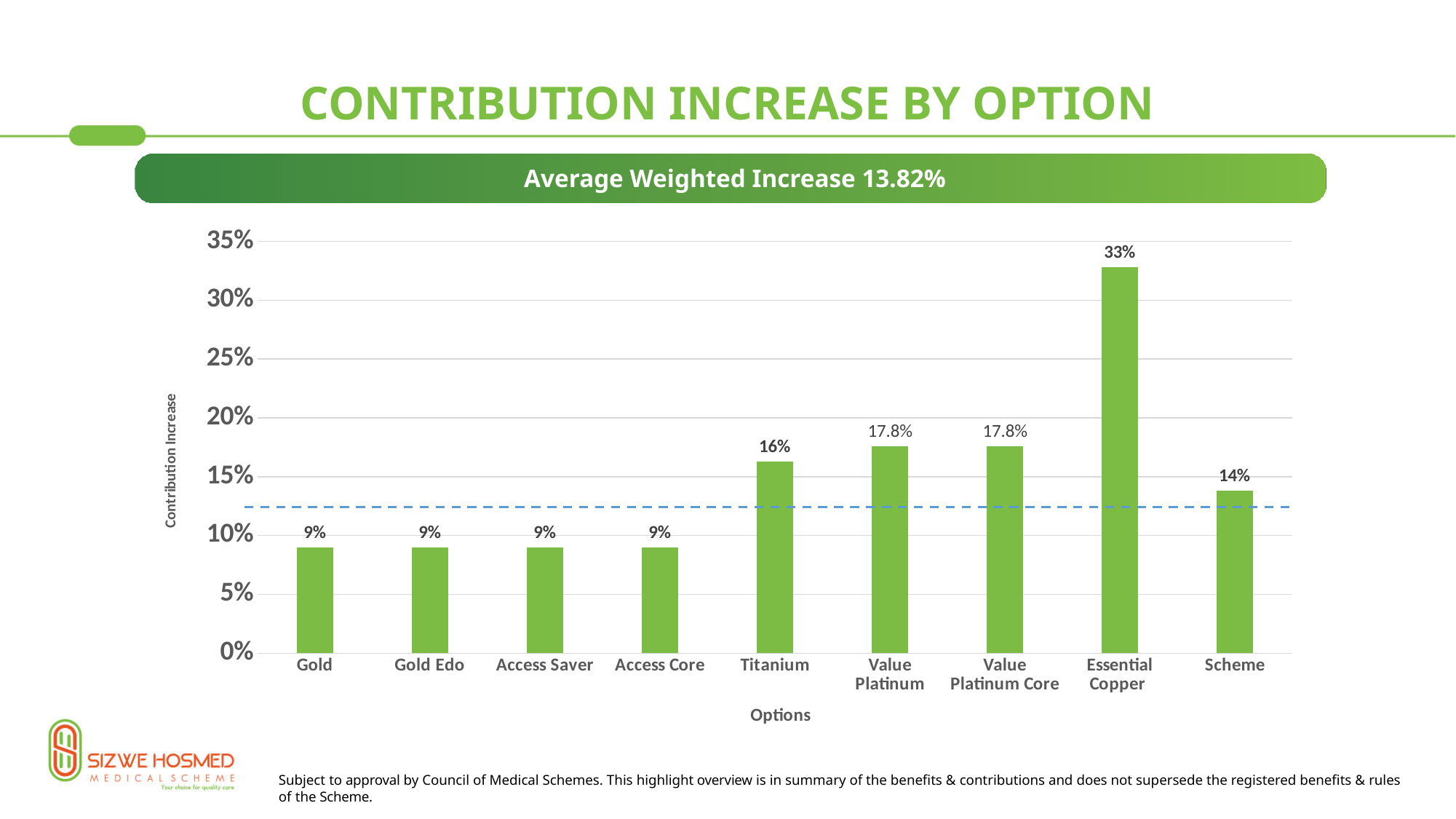
What is the contribution increase for Essential Copper? 33% What is the contribution increase for Value Platinum? 17.8% What is the contribution increase for Titanium? 16% How many options are shown on the x axis? 9 Which option has the highest contribution increase? Essential Copper Is the value for Essential Copper greater or less than 30%? greater Which is larger, the contribution increase for Titanium or for Scheme? Titanium What is the contribution increase for Scheme? 14% What is the difference between the contribution increase for Value Platinum Core and Scheme? 3.8% What is the average weighted increase stated on the slide? 13.82% What is the difference between the contribution increase for Essential Copper and Titanium? 17% What kind of chart is shown on the slide? Bar chart